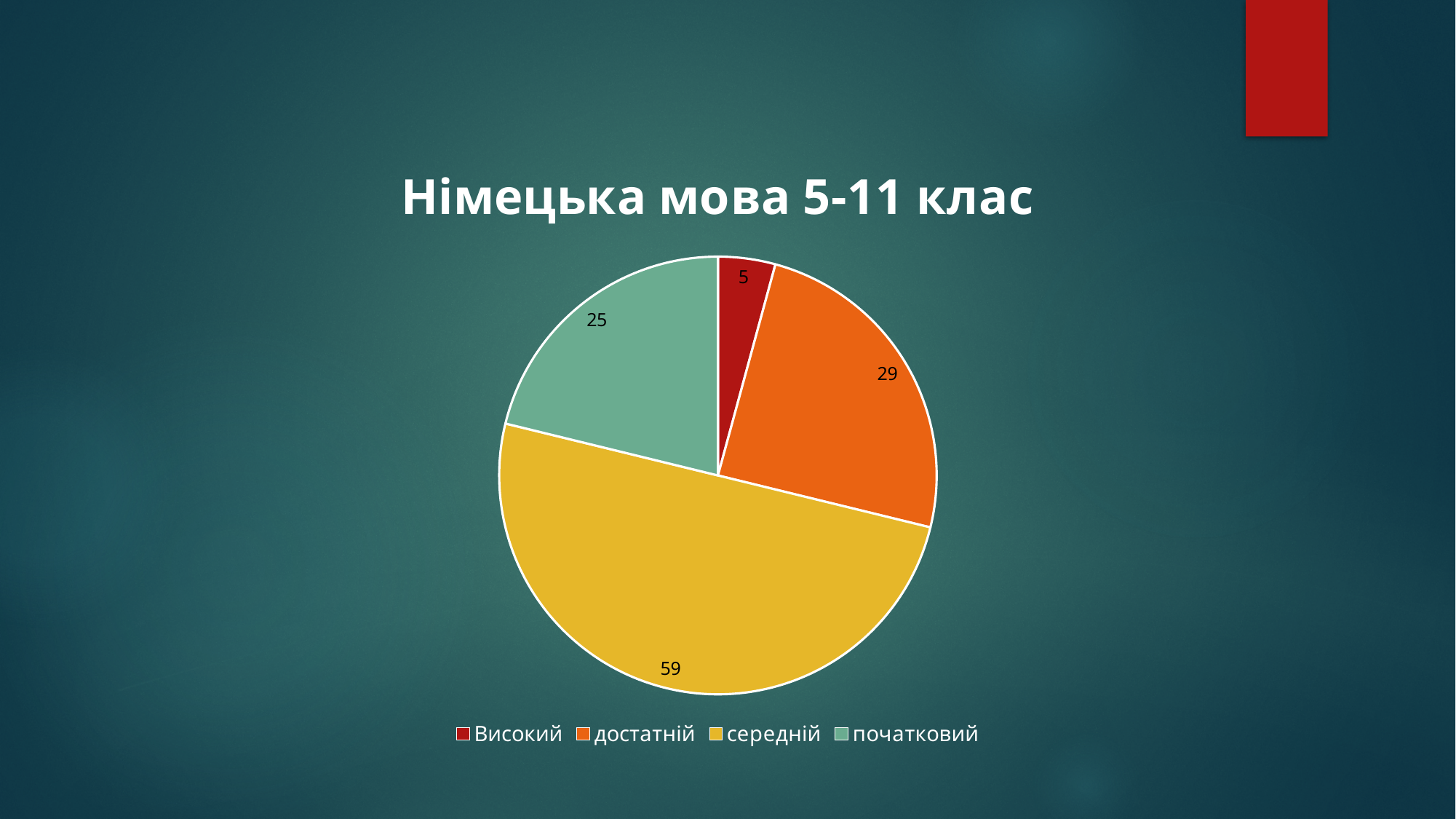
What is the difference between the values for 'середній' and 'достатній'? 30 What is the value for the 'Високий' slice? 5 What is the value for the 'середній' slice? 59 What share of the total does the 'середній' slice represent? 50% What kind of chart is shown on the slide? pie chart How many slices does the pie chart have? 4 Which category has the largest slice? середній Which is larger, the value for 'достатній' or the value for 'початковий'? достатній Which category has the smallest slice? Високий What is the title of the chart? Німецька мова 5-11 клас What is the value for the 'достатній' slice? 29 What is the value for the 'початковий' slice? 25